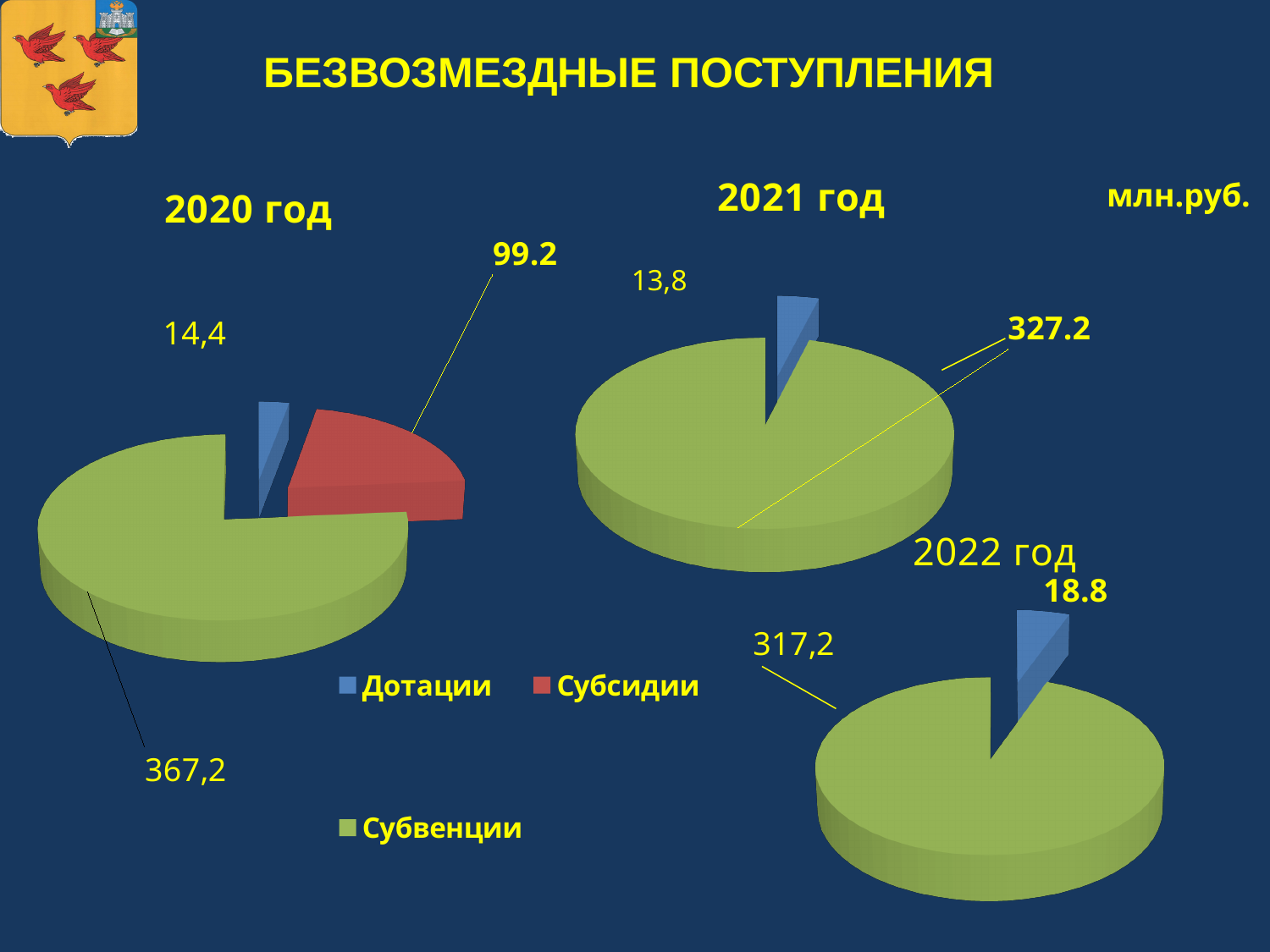
In the 2021 год pie chart, what is the value for Дотации? 13,8 In the 2022 год pie chart, what is the value for Субвенции? 317,2 What type of chart is used for 2021 год? Pie chart What is the difference between Субвенции and Субсидии in the 2020 год pie chart? 268,0 In the 2020 год pie chart, what is the value for Субвенции? 367,2 How many entries does the legend list? 3 In the 2020 год pie chart, which category has the smallest slice? Дотации In the 2022 год pie chart, which is larger, Дотации or Субвенции? Субвенции In the 2020 год pie chart, what is the value for Субсидии? 99.2 What is the total of the two slices in the 2021 год pie chart? 341,0 How many slices does the 2020 год pie chart have? 3 In the 2020 год pie chart, which category has the largest slice? Субвенции